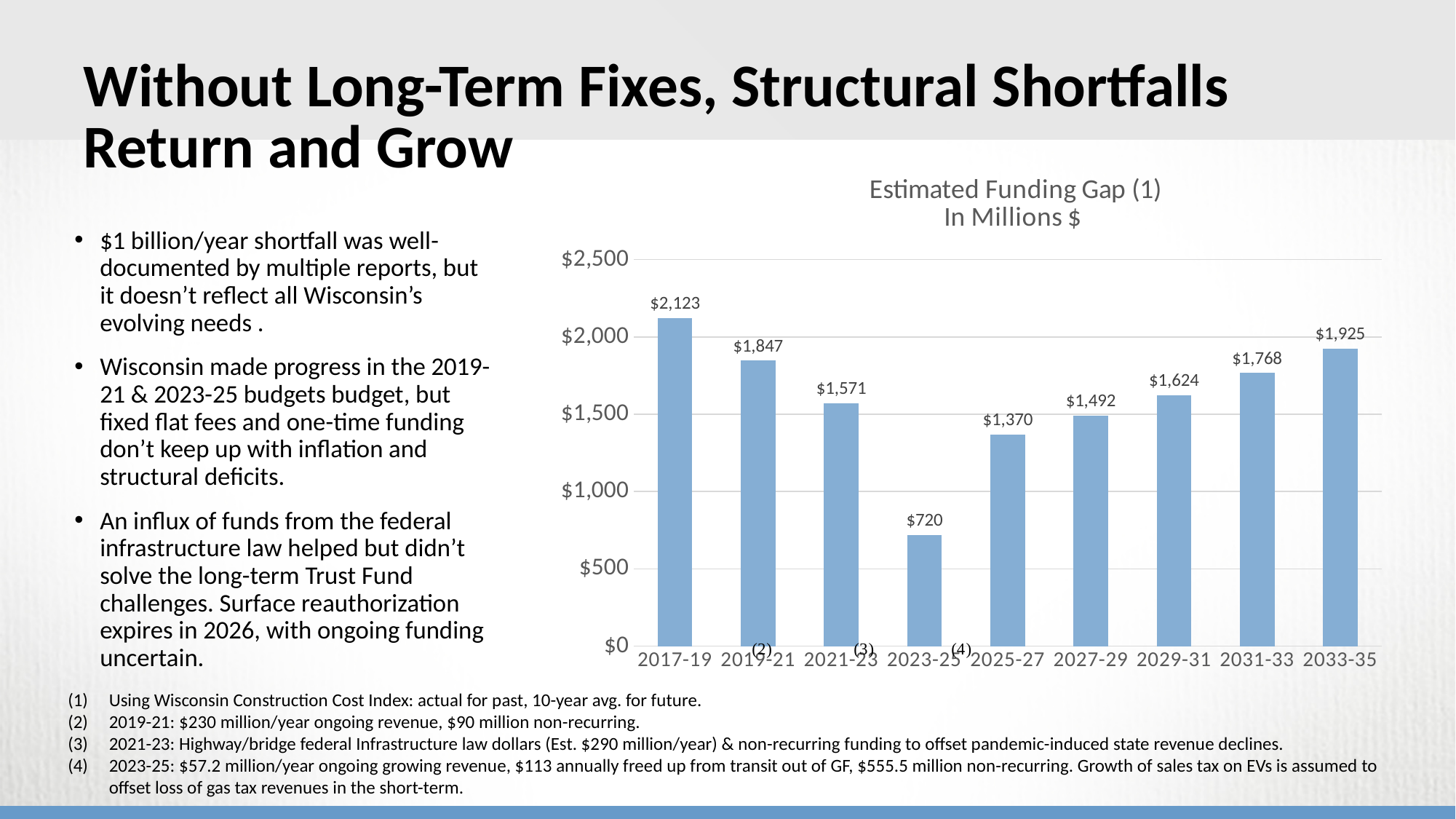
What is the estimated funding gap for 2017-19? $2,123 Which period has the lowest estimated funding gap? 2023-25 What is the estimated funding gap for 2023-25? $720 How many budget periods are shown on the chart? 9 What is the difference between the estimated funding gap for 2017-19 and 2019-21? $276 What kind of chart is shown on the slide? bar chart Which period has the highest estimated funding gap? 2017-19 What is the estimated funding gap for 2033-35? $1,925 Is the estimated funding gap for 2025-27 greater or less than $1,500? less What is the title of the chart? Estimated Funding Gap (1) In Millions $ Which is larger, the estimated funding gap for 2027-29 or for 2029-31? 2029-31 Do the estimated funding gap values rise or fall from 2023-25 to 2033-35? rise